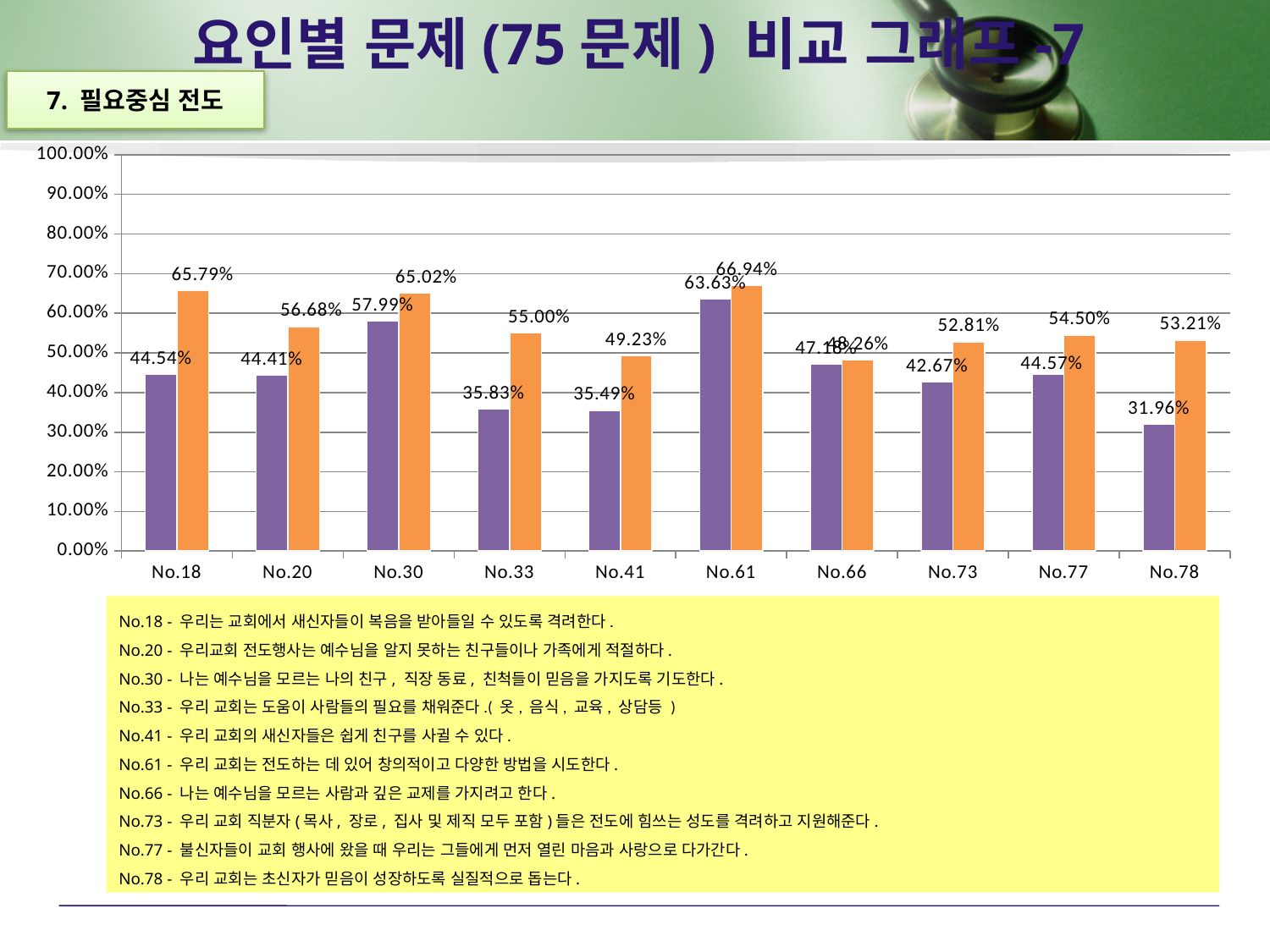
Which category has the highest purple bar? No.61 What kind of chart is shown on the slide? bar chart What is the difference between the orange and purple bars for No.78? 21.25% What is the value of the orange bar for No.18? 65.79% What is the difference between the purple bars for No.30 and No.20? 13.58% Which category has the highest orange bar? No.61 What is the value of the orange bar for No.33? 55.00% Which is larger, the purple bar for No.30 or the purple bar for No.73? No.30 Which category has the lowest purple bar? No.78 Is the purple bar for No.41 greater or less than 40.00%? less What is the value of the purple bar for No.78? 31.96% How many categories are shown on the x axis? 10